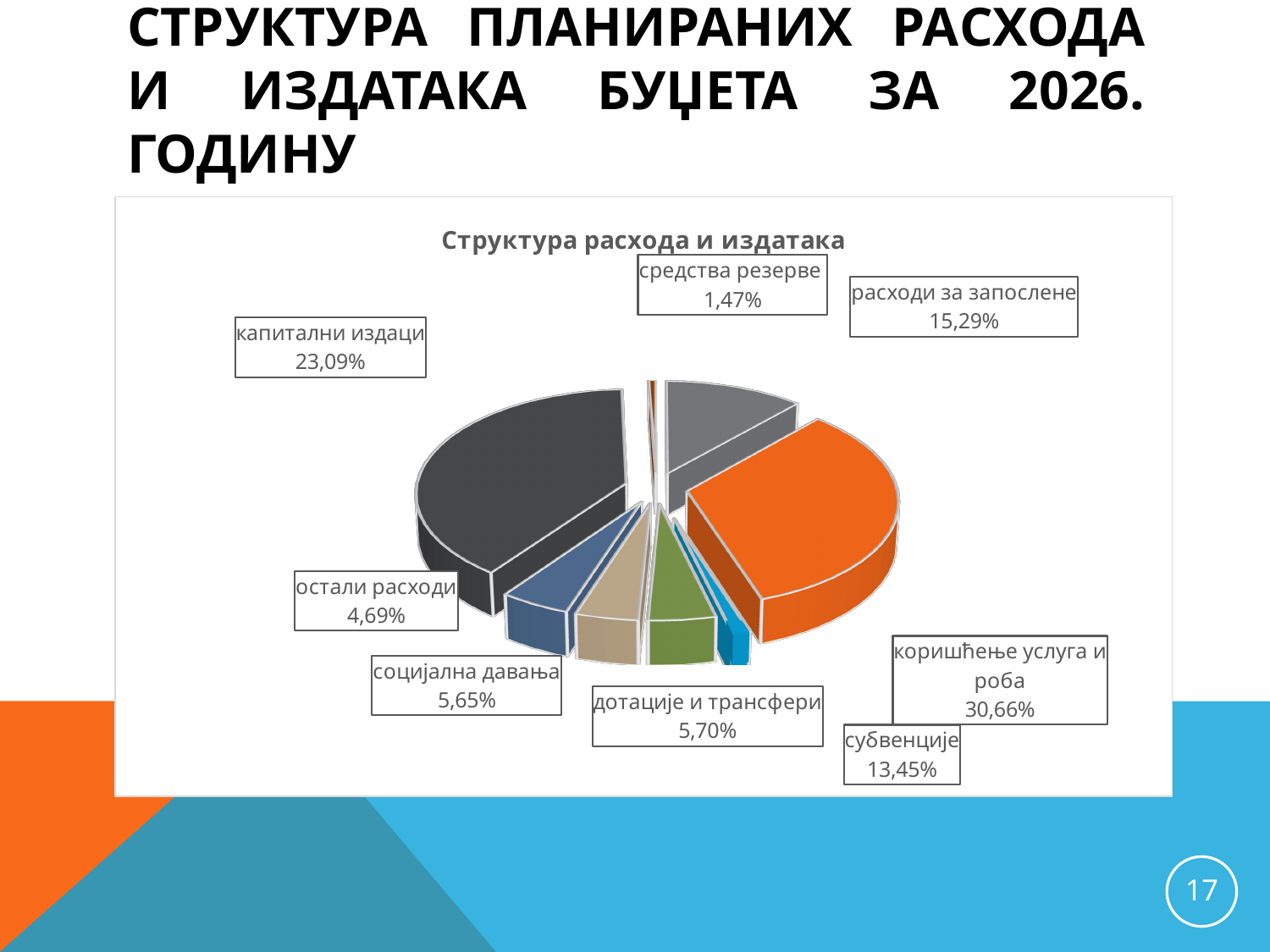
What kind of chart is shown on the slide? pie chart What is the difference between the shares of расходи за запослене and субвенције? 1,84% What is the value for средства резерве? 1,47% What share of the pie does коришћење услуга и роба represent? 30,66% Which is larger, the share for расходи за запослене or the share for субвенције? расходи за запослене What is the title of the chart? Структура расхода и издатака What percentage is shown for субвенције? 13,45% How many categories are shown in the pie chart? 8 What is the difference between the shares of коришћење услуга и роба and капитални издаци? 7,57% What is the value shown for капитални издаци? 23,09% Which category has the smallest share of the pie? средства резерве